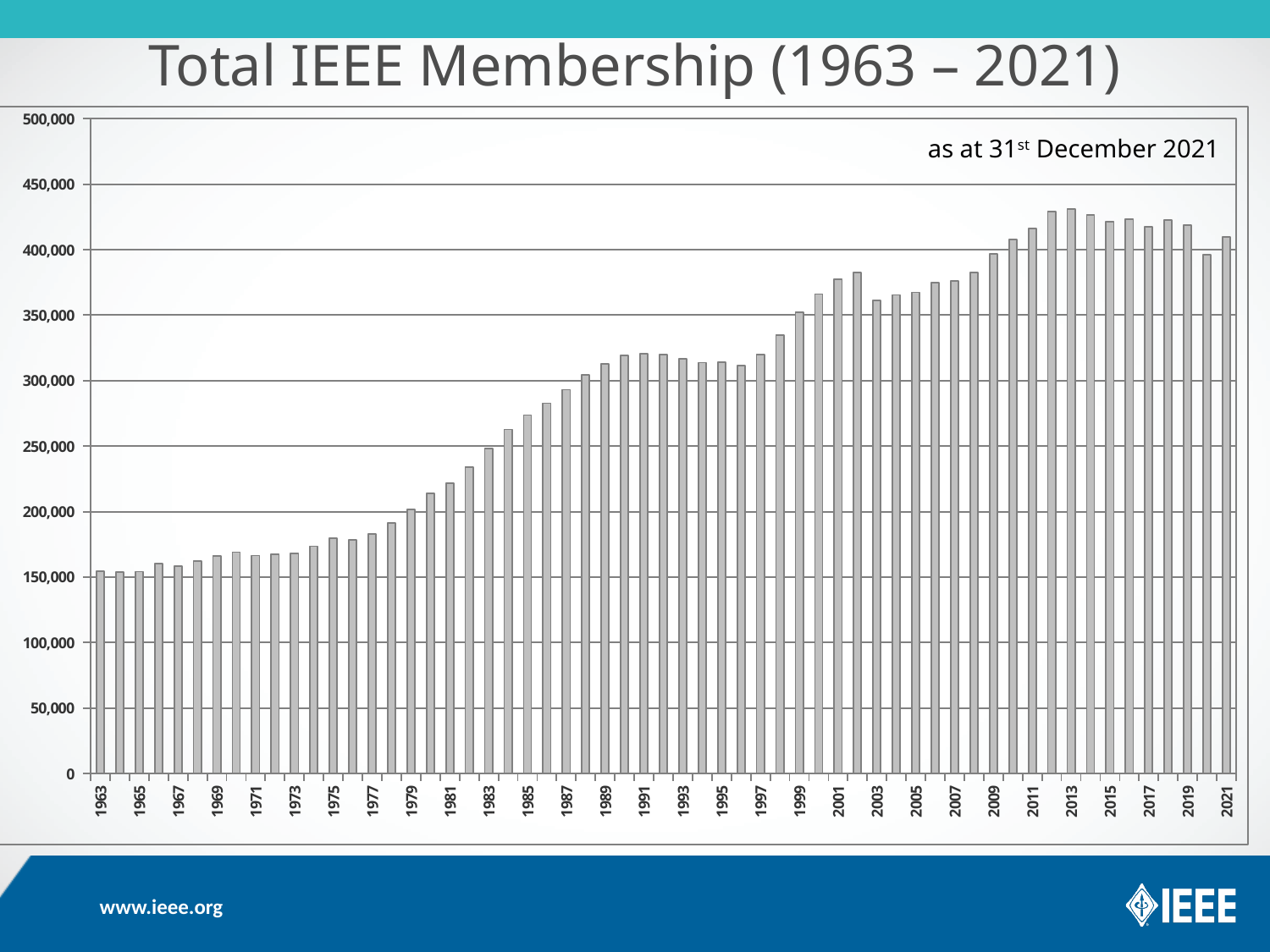
Is the membership value for 2003 greater or less than 350,000? greater Which year has the larger membership, 1963 or 2021? 2021 As at what date is the membership data reported, according to the note on the chart? 31st December 2021 Overall, does IEEE membership rise or fall from 1963 to 2021? rise What kind of chart is shown on the slide? bar chart What is the title of the chart? Total IEEE Membership (1963 – 2021) Is the membership value for 2021 greater or less than 400,000? greater Is the membership value for 1975 greater or less than 200,000? less Which year has the larger membership, 1989 or 1999? 1999 How many years (bars) are plotted in the chart, from 1963 to 2021 inclusive? 59